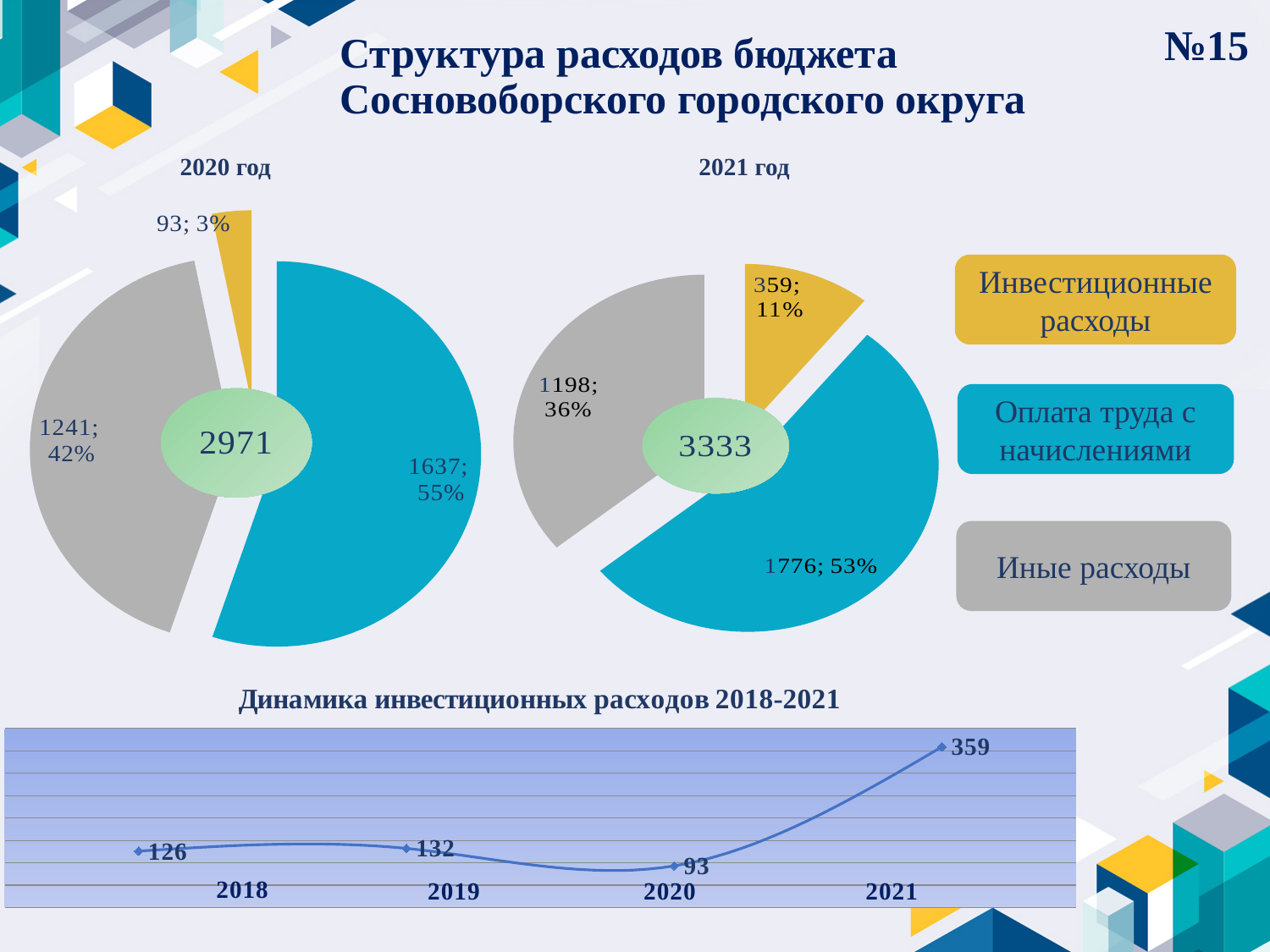
In the chart Динамика инвестиционных расходов 2018-2021, is the value for 2018 larger or smaller than the value for 2019? smaller What is the difference between the Инвестиционные расходы values in the 2021 год and 2020 год pie charts? 266 In the 2021 год pie chart, which category has the smallest slice? Инвестиционные расходы In the 2020 год pie chart, what is the value and share shown for Инвестиционные расходы? 93; 3% In the 2021 год pie chart, what share does Иные расходы have? 36% In the 2021 год pie chart, what is the value and share shown for Оплата труда с начислениями? 1776; 53% What kind of chart is Динамика инвестиционных расходов 2018-2021? line chart In the chart Динамика инвестиционных расходов 2018-2021, how many data points are plotted? 4 In the 2020 год pie chart, which category has the largest slice? Оплата труда с начислениями In the chart Динамика инвестиционных расходов 2018-2021, which year has the lowest value? 2020 In the chart Динамика инвестиционных расходов 2018-2021, what is the value for 2019? 132 What total is shown in the centre of the 2021 год pie chart? 3333